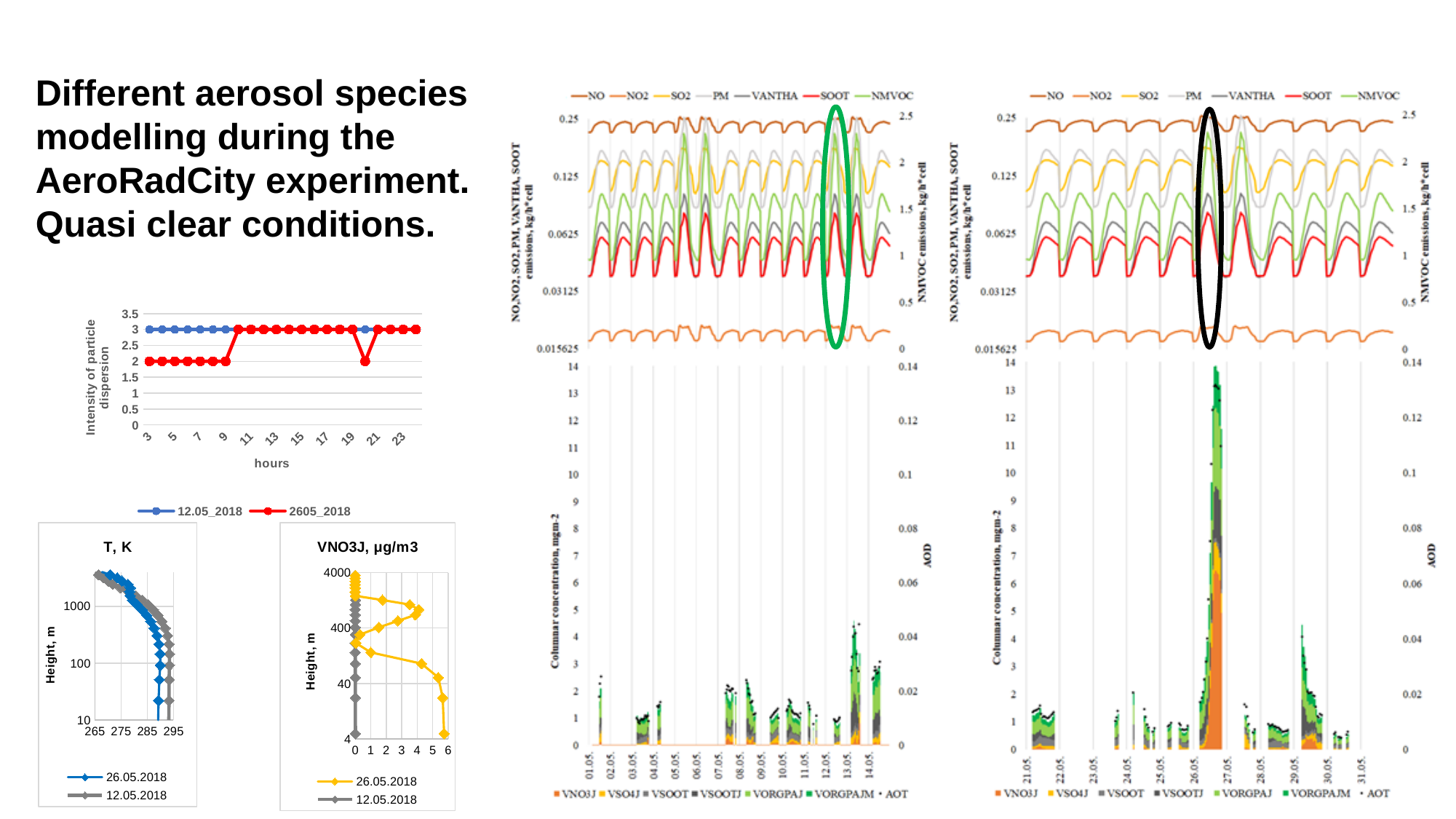
On the 'Intensity of particle dispersion' chart, what is the lowest value reached by the 2605_2018 series? 2 On the 'Intensity of particle dispersion' chart, what is the highest value reached by the 2605_2018 series? 3 On the bottom-right columnar concentration chart (dates 21.05 to 31.05), is the tallest peak greater or less than 10 on the left axis? greater On the top-right emissions charts, how many series does the legend list? 7 On the 'Intensity of particle dispersion' chart, how many series does the legend list? 2 On the 'VNO3J, µg/m3' chart, which series reaches the higher concentration values? 26.05.2018 On the 'Intensity of particle dispersion' chart, what is the value for 12.05_2018 at hour 5? 3 On the 'T, K' chart, how many series does the legend list? 2 On the 'Intensity of particle dispersion' chart, what is the value for 2605_2018 at hour 5? 2 What kind of chart is the 'Intensity of particle dispersion' chart? line chart On the 'Intensity of particle dispersion' chart, which series has the higher value at hour 7? 12.05_2018 On the bottom-middle columnar concentration chart (dates 01.05 to 14.05), is the tallest bar greater or less than 5 on the left axis? less